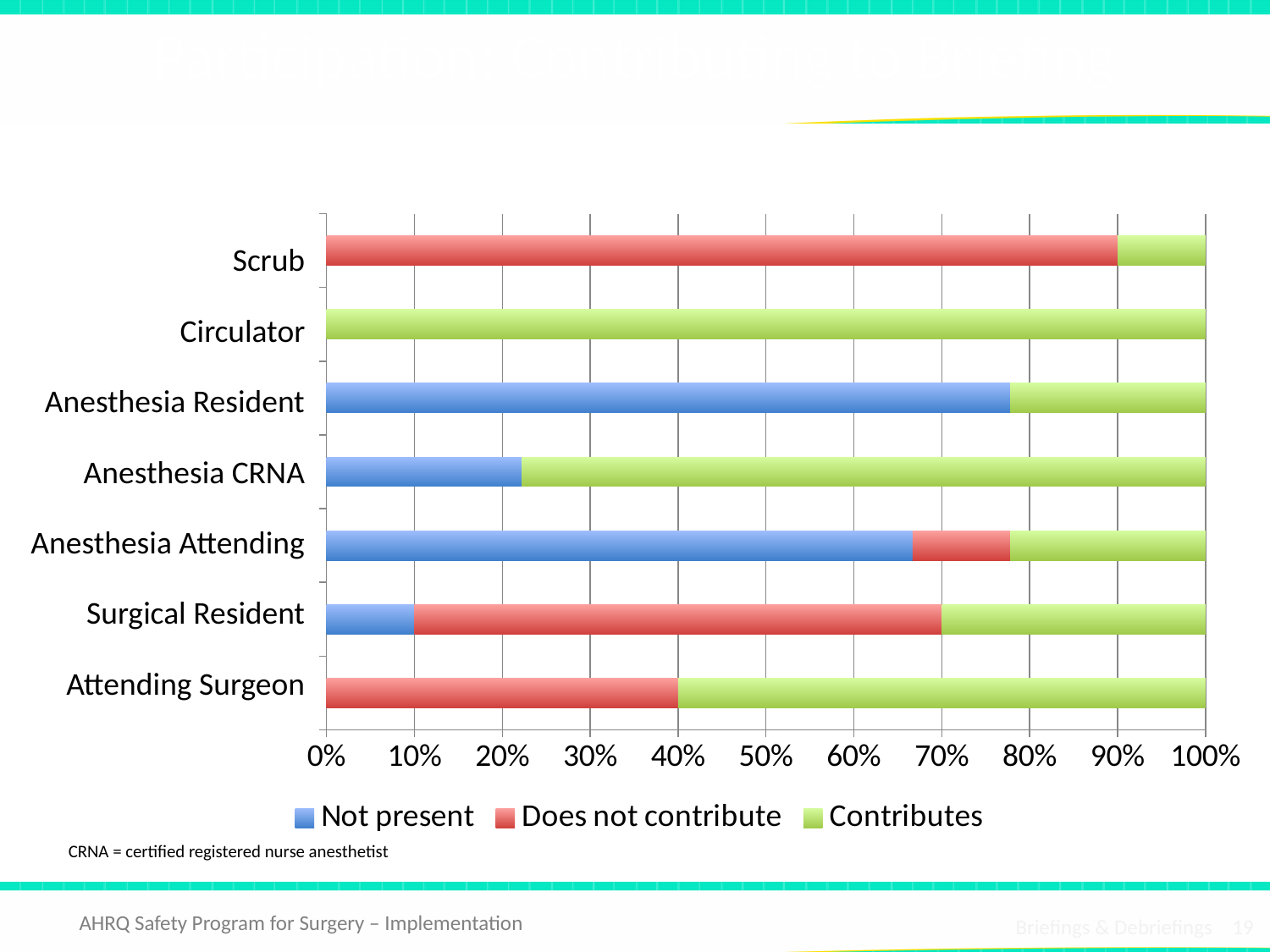
Which role has the largest 'Does not contribute' share in the chart? Scrub Which colour represents the 'Contributes' series in the chart? Green What are the three series named in the chart legend? Not present, Does not contribute, Contributes Is the 'Contributes' share for Scrub greater or less than 20%? less Which has the larger 'Not present' share: Anesthesia Resident or Anesthesia CRNA? Anesthesia Resident How many categories (roles) are listed on the vertical axis of the chart? 7 Is the 'Not present' share for Anesthesia CRNA greater or less than 30%? less Is the 'Not present' share for Anesthesia Resident greater or less than 70%? greater What kind of chart is shown on the slide? Stacked bar chart How many series does the chart legend list? 3 Which role has the largest 'Contributes' share in the chart? Circulator Which role has the largest 'Not present' share in the chart? Anesthesia Resident